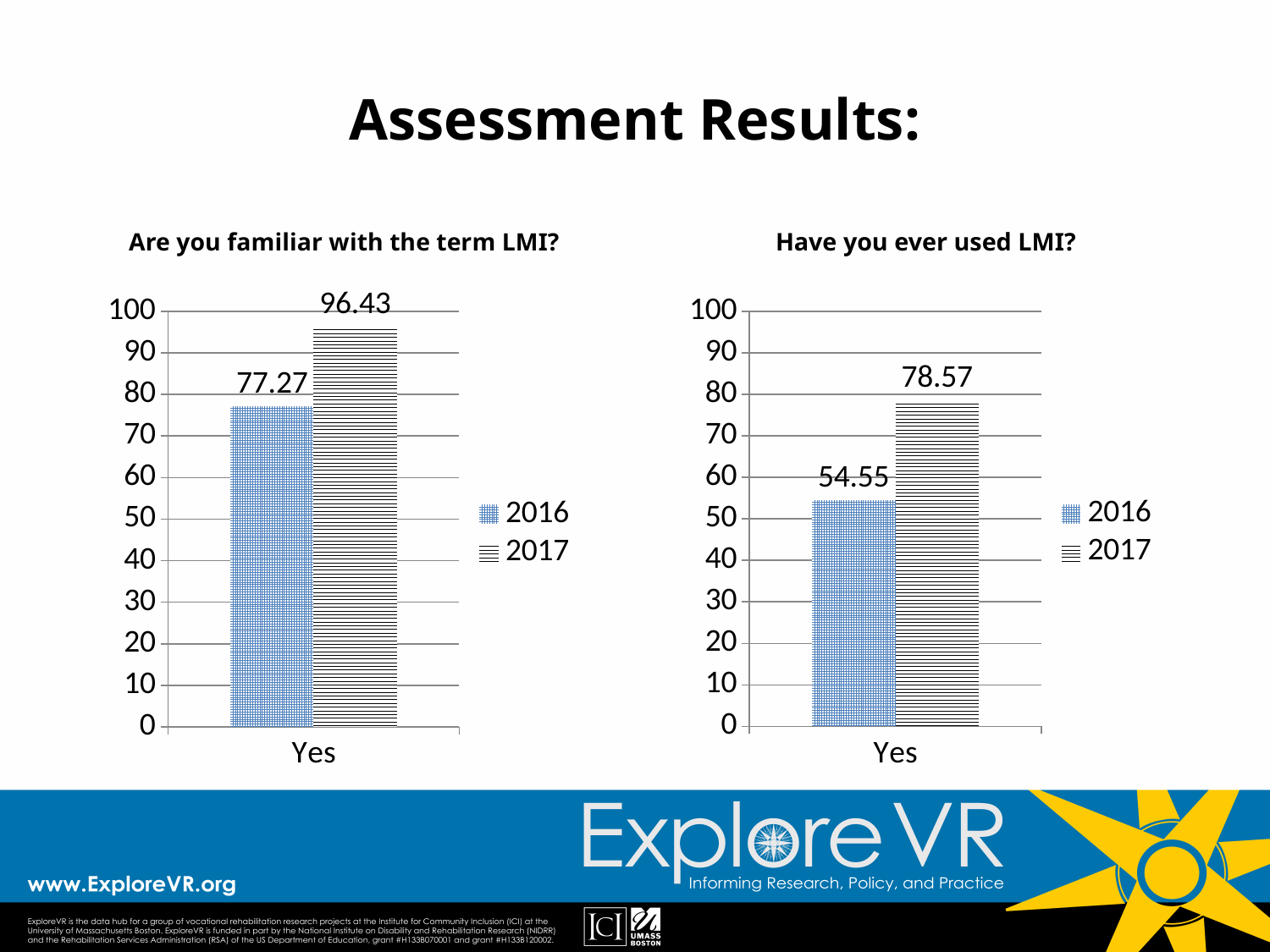
In the chart titled "Have you ever used LMI?", which series has the lower value? 2016 In the chart titled "Have you ever used LMI?", what is the value for 2017? 78.57 In the chart titled "Are you familiar with the term LMI?", what is the value for 2016? 77.27 In the chart titled "Are you familiar with the term LMI?", what is the difference between the 2017 and 2016 values? 19.16 How many series does the legend list in the chart titled "Are you familiar with the term LMI?"? 2 In the chart titled "Have you ever used LMI?", what is the difference between the 2017 and 2016 values? 24.02 In the chart titled "Have you ever used LMI?", what is the value for 2016? 54.55 What kind of chart is the chart titled "Have you ever used LMI?"? bar chart In the chart titled "Have you ever used LMI?", is the value for 2016 greater or less than 60? less What is the category label on the x axis of the chart titled "Are you familiar with the term LMI?"? Yes In the chart titled "Are you familiar with the term LMI?", what is the value for 2017? 96.43 In the chart titled "Are you familiar with the term LMI?", which series has the higher value, 2016 or 2017? 2017